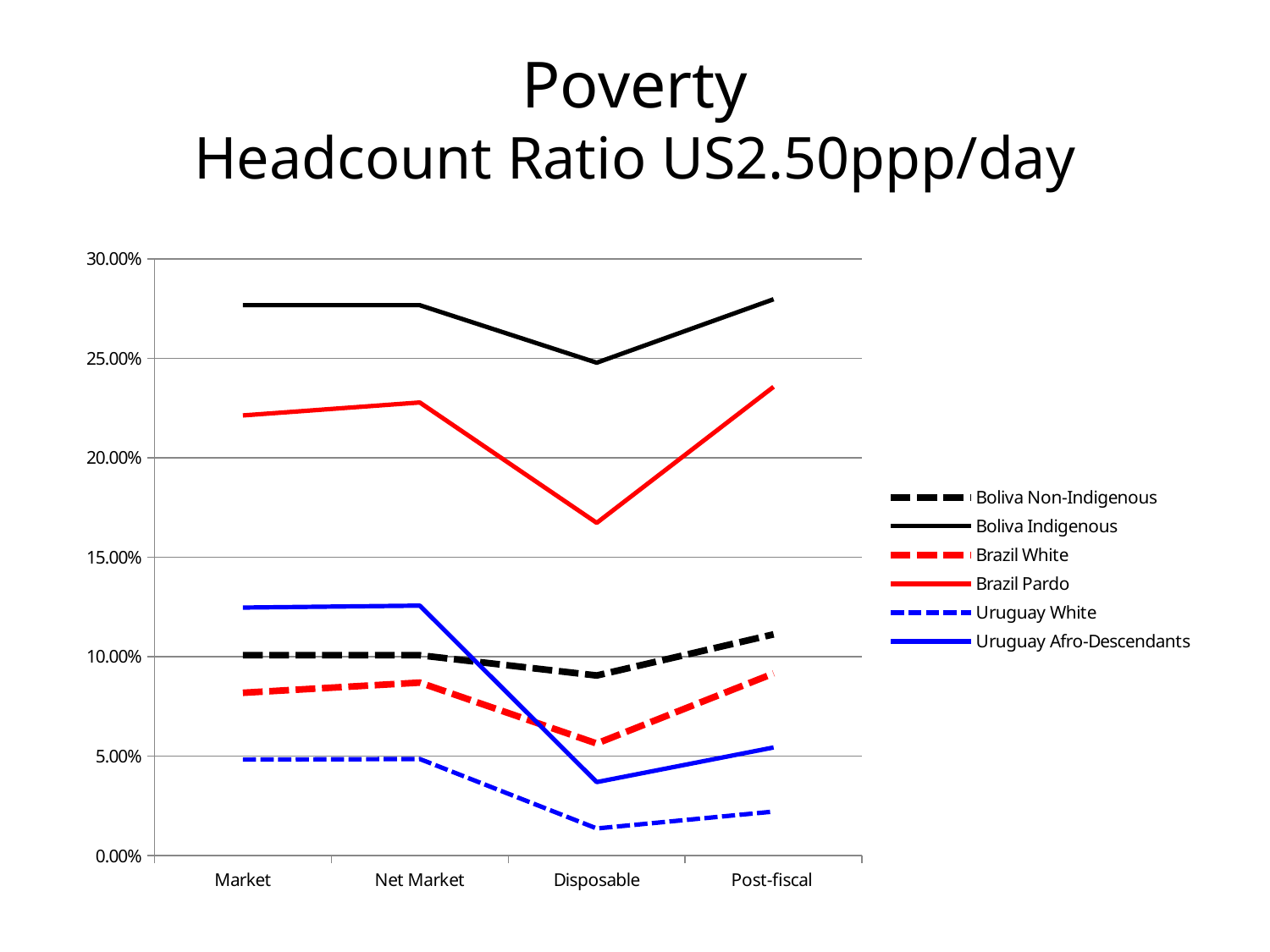
Does the Uruguay Afro-Descendants line rise or fall from Net Market to Disposable? fall Which series has the highest value at Market? Boliva Indigenous At Disposable, which is larger: Brazil White or Uruguay Afro-Descendants? Brazil White What kind of chart is shown on the slide? line chart Is the value for Uruguay Afro-Descendants at Market greater or less than 10.00%? greater Is the value for Uruguay White at Disposable greater or less than 5.00%? less Is the value for Brazil Pardo at Disposable greater or less than 20.00%? less Which series has the lowest value at Disposable? Uruguay White At Post-fiscal, which is larger: Brazil Pardo or Boliva Non-Indigenous? Brazil Pardo How many series does the legend list? 6 What colour are the Uruguay series lines in the chart? blue How many categories are shown along the x axis? 4